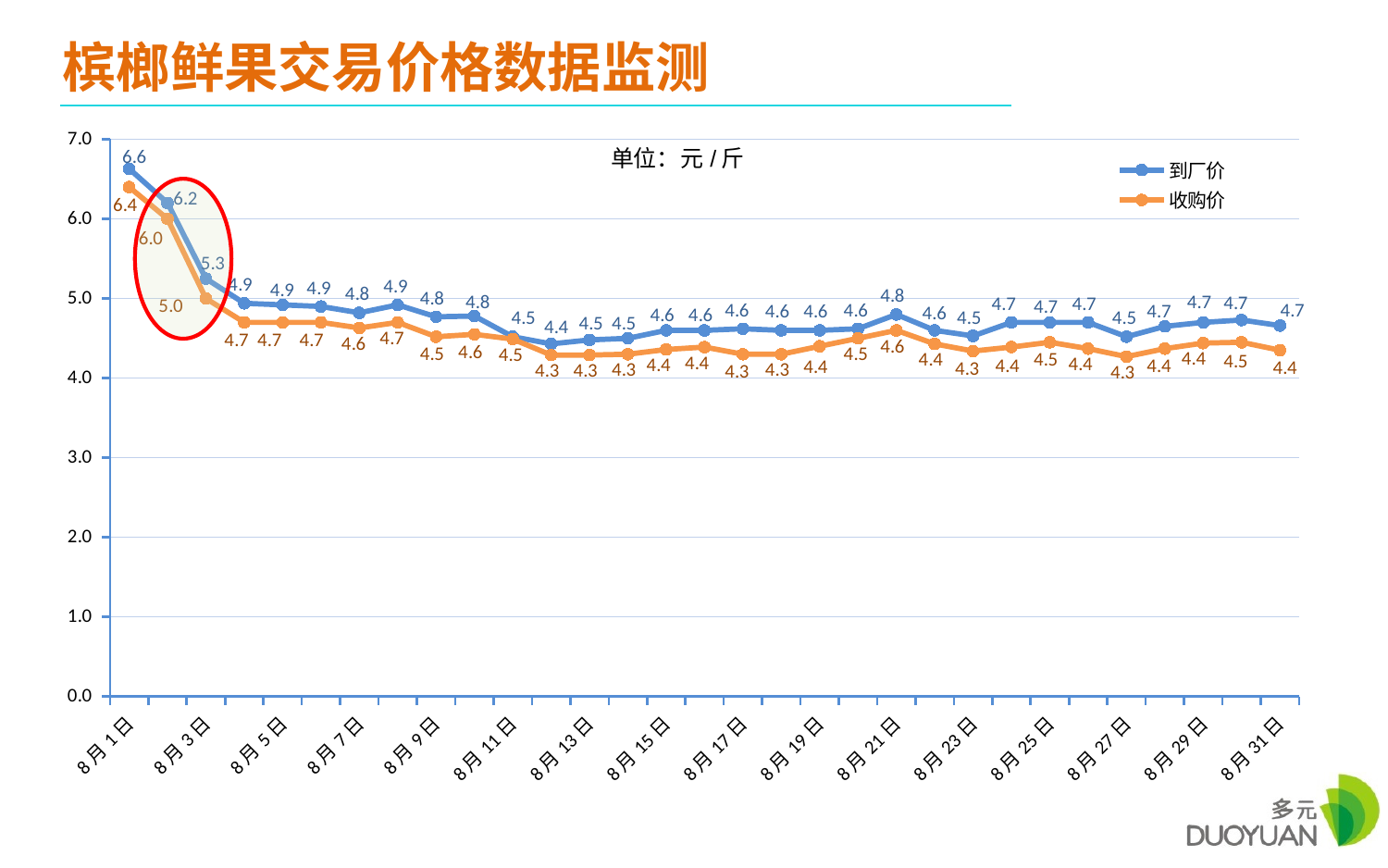
On 8月21日, which is larger, 到厂价 or 收购价? 到厂价 What unit is stated on the chart? 元/斤 What is the 收购价 value on 8月1日? 6.4 What is the 到厂价 value on 8月3日? 5.3 What is the lowest 到厂价 value shown on the chart? 4.4 On which date is the 到厂价 highest? 8月1日 What is the 到厂价 value on 8月1日? 6.6 What kind of chart is shown on the slide? line chart How many series does the legend list? 2 What is the 收购价 value on 8月31日? 4.4 What is the difference between 到厂价 and 收购价 on 8月3日? 0.3 Do the 收购价 values generally rise or fall from 8月1日 to 8月31日? fall